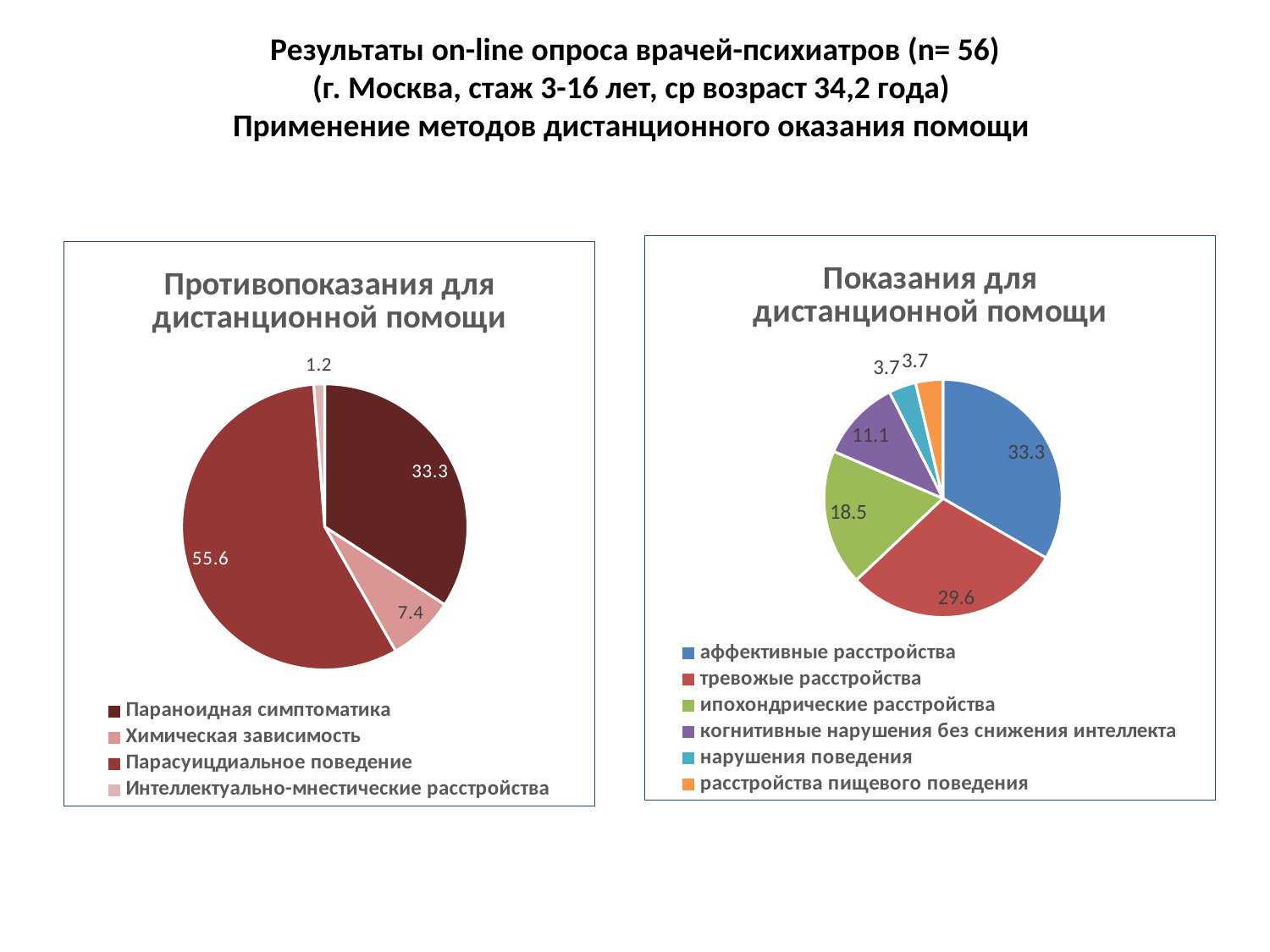
In the chart titled «Противопоказания для дистанционной помощи», how many categories does the legend list? 4 In the chart titled «Показания для дистанционной помощи», how many categories does the legend list? 6 In the chart titled «Противопоказания для дистанционной помощи», what is the value for «Парасуицидальное поведение»? 55.6 In the chart titled «Противопоказания для дистанционной помощи», what is the value for «Химическая зависимость»? 7.4 In the chart titled «Противопоказания для дистанционной помощи», which category has the smallest slice? Интеллектуально-мнестические расстройства In the chart titled «Показания для дистанционной помощи», what is the value for «когнитивные нарушения без снижения интеллекта»? 11.1 In the chart titled «Показания для дистанционной помощи», which is larger: «тревожые расстройства» or «ипохондрические расстройства»? тревожые расстройства In the chart titled «Показания для дистанционной помощи», what is the value for «ипохондрические расстройства»? 18.5 What type of chart is the chart titled «Показания для дистанционной помощи»? Pie chart In the chart titled «Показания для дистанционной помощи», which category has the largest slice? аффективные расстройства In the chart titled «Противопоказания для дистанционной помощи», which category has the largest slice? Парасуицдиальное поведение In the chart titled «Противопоказания для дистанционной помощи», what is the difference between the values for «Парасуицидальное поведение» and «Параноидная симптоматика»? 22.3